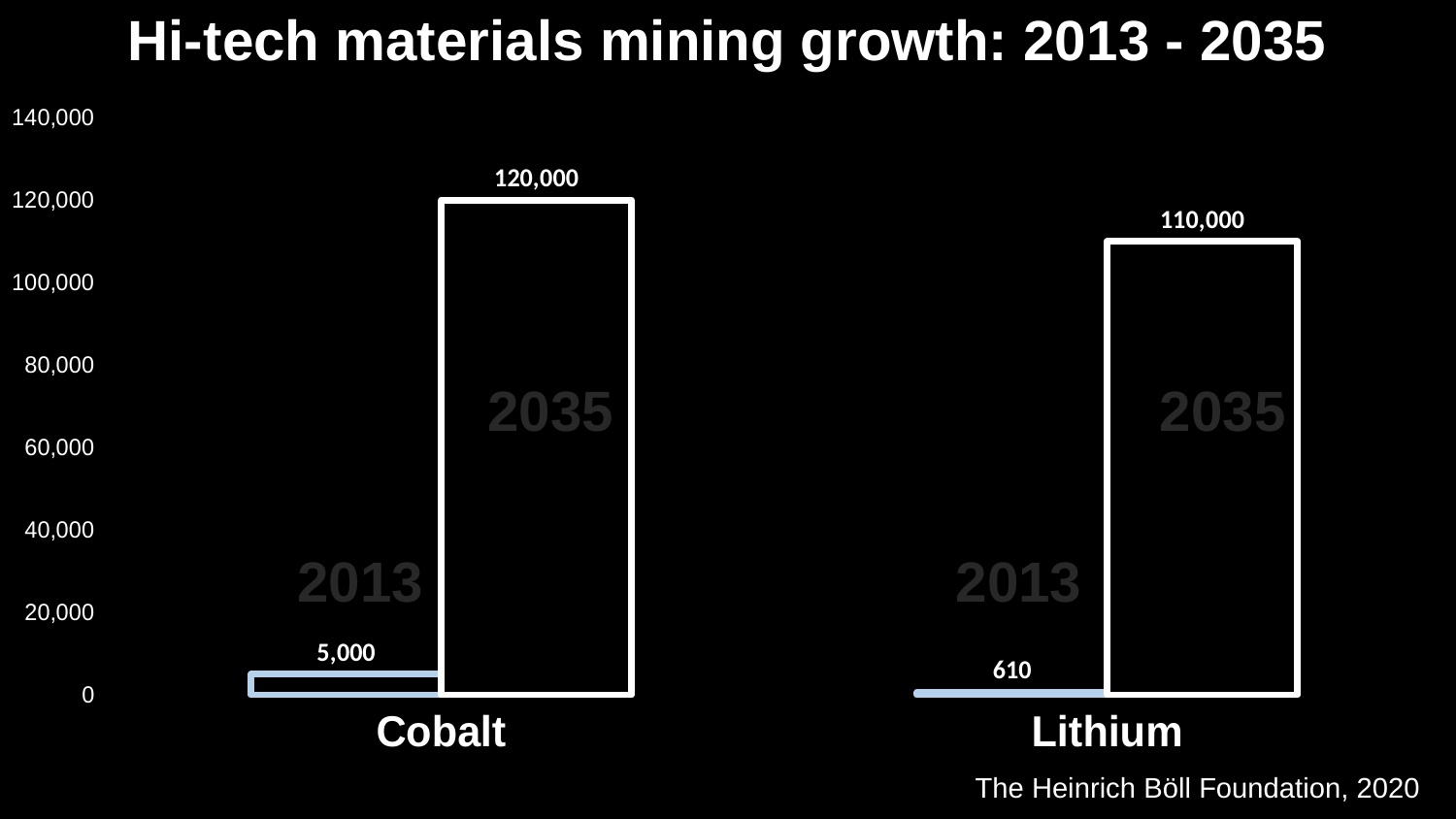
What is the title of the chart? Hi-tech materials mining growth: 2013 - 2035 What is the difference between the 2035 and 2013 values for Cobalt? 115,000 How many materials are shown on the x axis? 2 Is the 2013 value for Cobalt larger or smaller than the 2013 value for Lithium? larger What is the 2035 value for Lithium? 110,000 What is the 2035 value for Cobalt? 120,000 What kind of chart is shown on the slide? bar chart What is the 2013 value for Cobalt? 5,000 What is the 2013 value for Lithium? 610 Which material has the higher 2035 value? Cobalt Which material has the lower 2013 value? Lithium What is the difference between the 2035 values for Cobalt and Lithium? 10,000